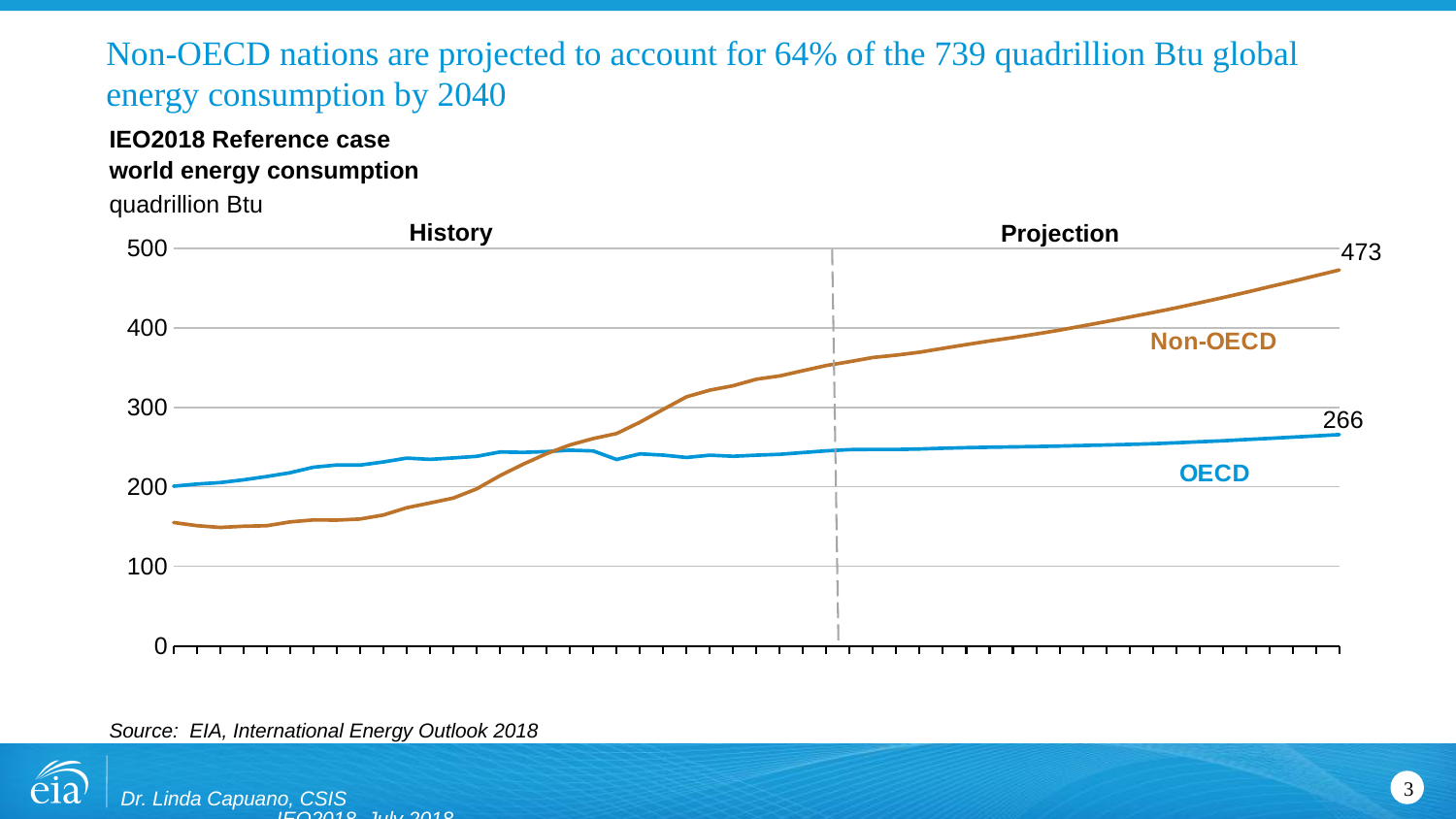
How many series are plotted on the chart? 2 What is the value labeled at the end of the OECD line? 266 Which series has the larger value at the end of the projection, Non-OECD or OECD? Non-OECD What unit is the chart's y axis measured in? quadrillion Btu Does the Non-OECD line rise or fall over the projection period? rises What is the combined value of the Non-OECD and OECD lines at the end of the projection? 739 What are the two period labels shown above the chart? History and Projection Is the value of the Non-OECD line at the start of the chart greater or less than 200? less What kind of chart is shown on the slide? line chart What is the value labeled at the end of the Non-OECD line? 473 What is the difference between the final Non-OECD value and the final OECD value? 207 Is the value of the OECD line at the start of the chart greater or less than 300? less